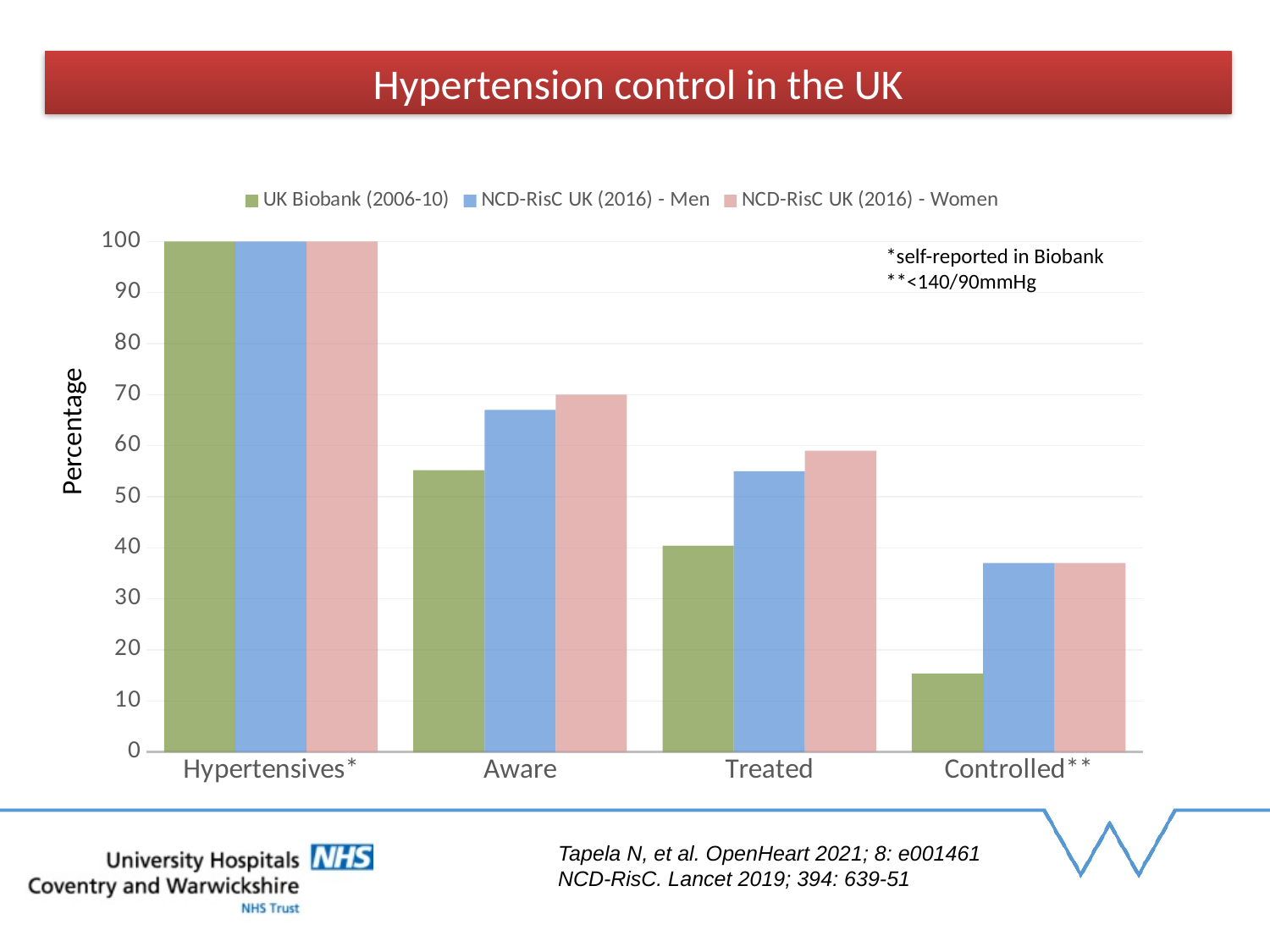
What is the value for UK Biobank (2006-10) in the Hypertensives* category? 100 What is the value for NCD-RisC UK (2016) - Women in the Hypertensives* category? 100 In the Aware category, which is larger: UK Biobank (2006-10) or NCD-RisC UK (2016) - Women? NCD-RisC UK (2016) - Women Is the value for UK Biobank (2006-10) in the Aware category greater or less than 50? greater Do the UK Biobank (2006-10) values rise or fall from left to right across the categories? fall Is the value for UK Biobank (2006-10) in the Controlled** category greater or less than 20? less What is the label on the y axis? Percentage For the UK Biobank (2006-10) series, which category has the lowest value? Controlled** How many series does the legend list? 3 Is the value for NCD-RisC UK (2016) - Men in the Treated category greater or less than 60? less How many categories are shown on the x axis? 4 What kind of chart is shown on the slide? bar chart